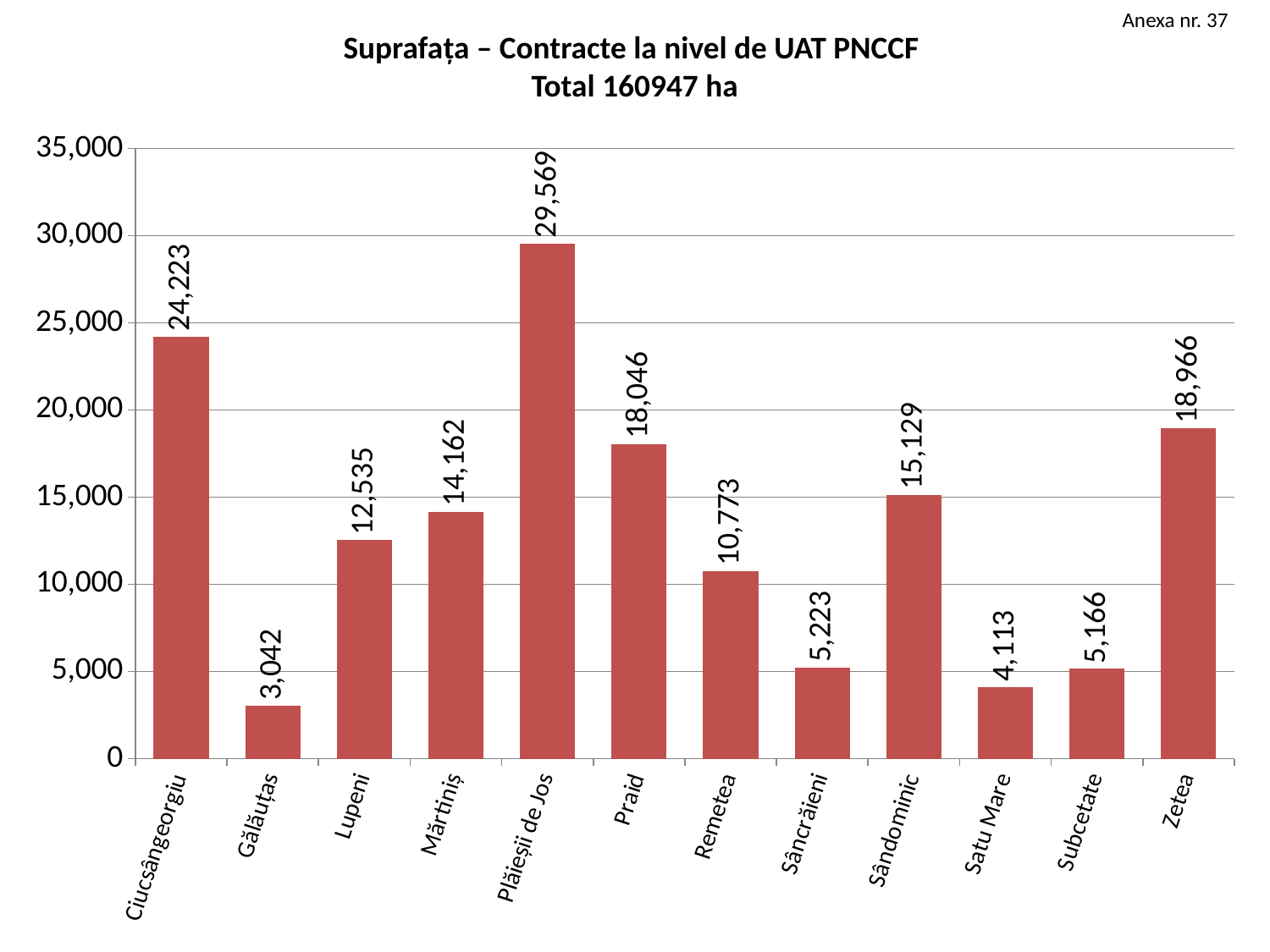
What is the value for Zetea? 18,966 What is the value for Gălăuțaș? 3,042 What is the difference between the values for Plăieșii de Jos and Ciucsângeorgiu? 5,346 How many categories are shown on the x axis? 12 What is the value for Sândominic? 15,129 What is the difference between the values for Zetea and Praid? 920 Is the value for Remetea greater or less than 10,000? greater Which category has the lowest value? Gălăuțaș Which is larger, the value for Lupeni or the value for Mărtiniș? Mărtiniș What kind of chart is shown on the slide? bar chart What is the value for Plăieșii de Jos? 29,569 Which category has the highest value? Plăieșii de Jos